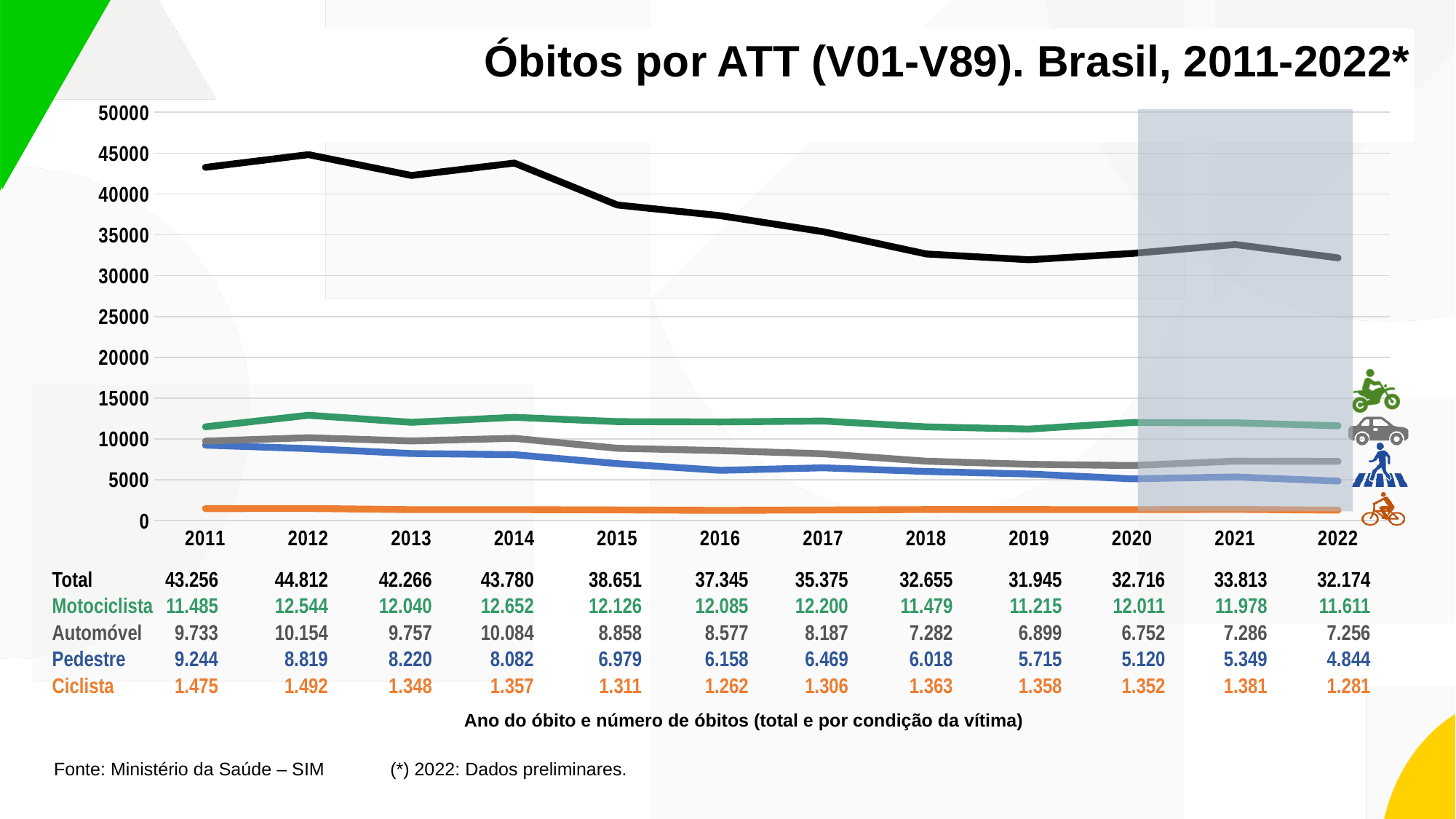
In which year was the Total highest? 2012 What was the total number of deaths (Total) in 2015? 38.651 Which was larger in 2014, Automóvel or Pedestre? Automóvel What is the Ciclista value for 2018? 1.363 In which year was the Pedestre value lowest? 2022 What kind of chart is shown on the slide? line chart Does the Total line generally rise or fall from 2011 to 2022? fall How many series (rows) does the data table below the chart list? 5 How many years are shown on the x axis? 12 How many Pedestre deaths were recorded in 2022? 4.844 In which year was the Total lowest? 2019 What is the difference between the Total in 2011 and the Total in 2022? 11.082